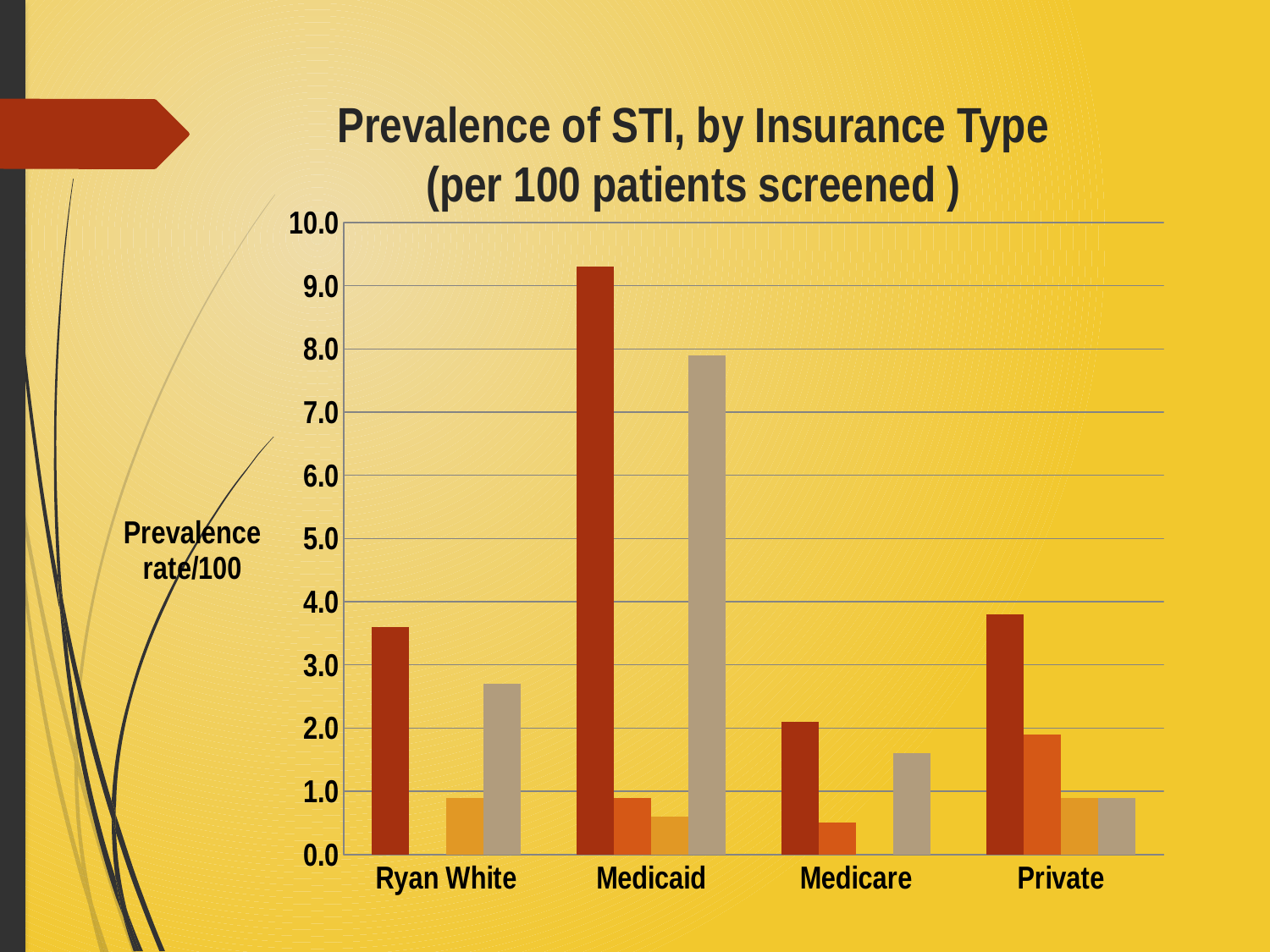
How many insurance type categories are shown on the x axis? 4 Is the value of the dark red bar for Medicare greater or less than 3.0? less For Medicaid, which is larger: the dark red bar or the grey bar? the dark red bar Which is larger: the grey bar for Ryan White or the grey bar for Medicare? the grey bar for Ryan White What kind of chart is shown on the slide? bar chart Is the value of the grey bar for Medicaid greater or less than 7.0? greater Is the value of the dark red bar for Ryan White greater or less than 4.0? less Which insurance type has the shortest dark red bar? Medicare Which insurance type has the tallest dark red bar? Medicaid What is the title of the chart? Prevalence of STI, by Insurance Type (per 100 patients screened ) What label is shown on the vertical axis of the chart? Prevalence rate/100